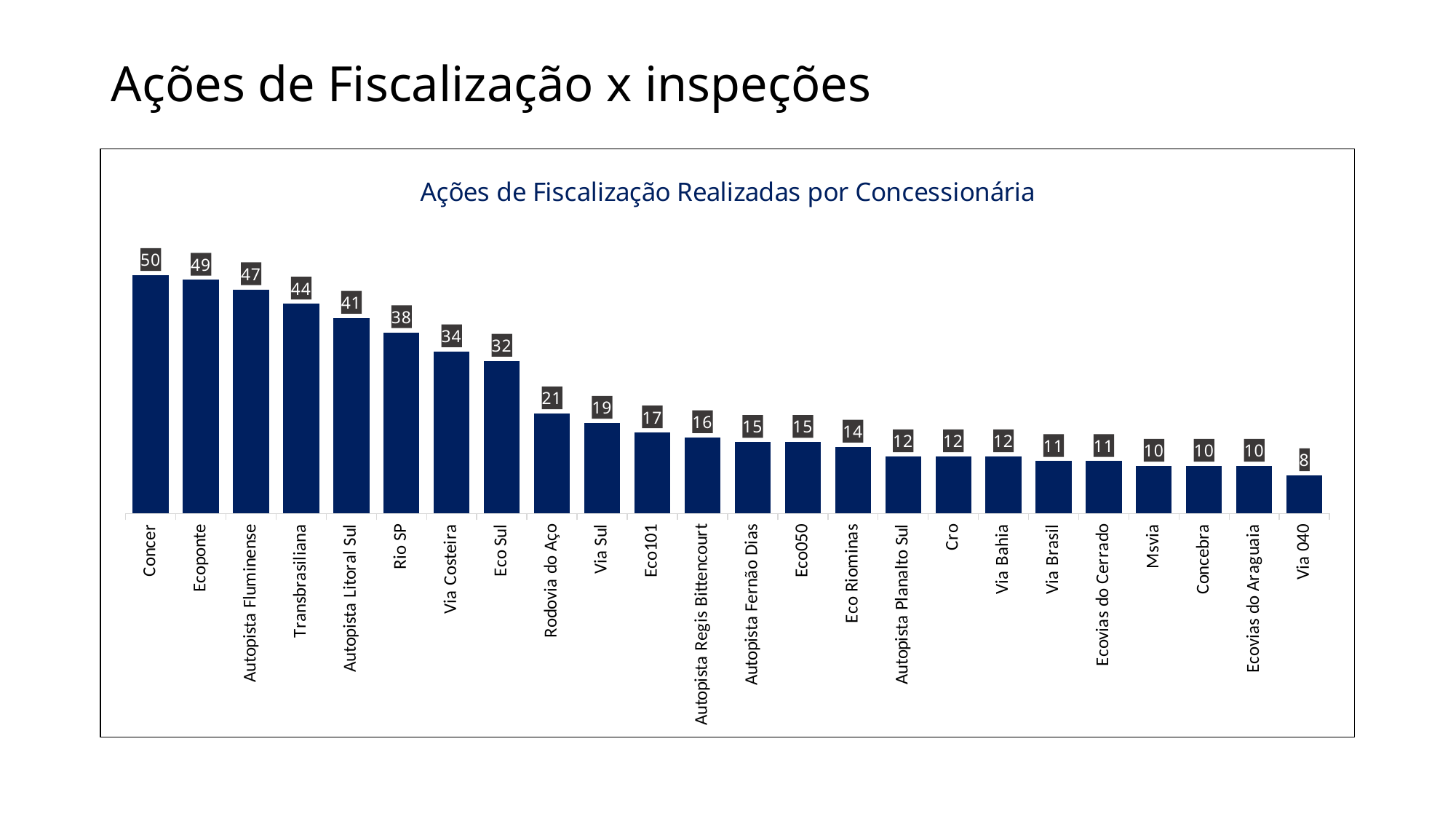
What is the value for Concer? 50 What kind of chart is shown? Bar chart What is the value for Eco050? 15 What is the difference between the values for Ecoponte and Eco Sul? 17 Which concessionária has the lowest value? Via 040 What is the difference between the values for Transbrasiliana and Via Sul? 25 What is the title of the chart? Ações de Fiscalização Realizadas por Concessionária What is the value for Rio SP? 38 What is the value for Rodovia do Aço? 21 Which is larger, the value for Via Costeira or the value for Eco101? Via Costeira How many concessionárias are shown on the chart? 24 Which concessionária has the highest value? Concer